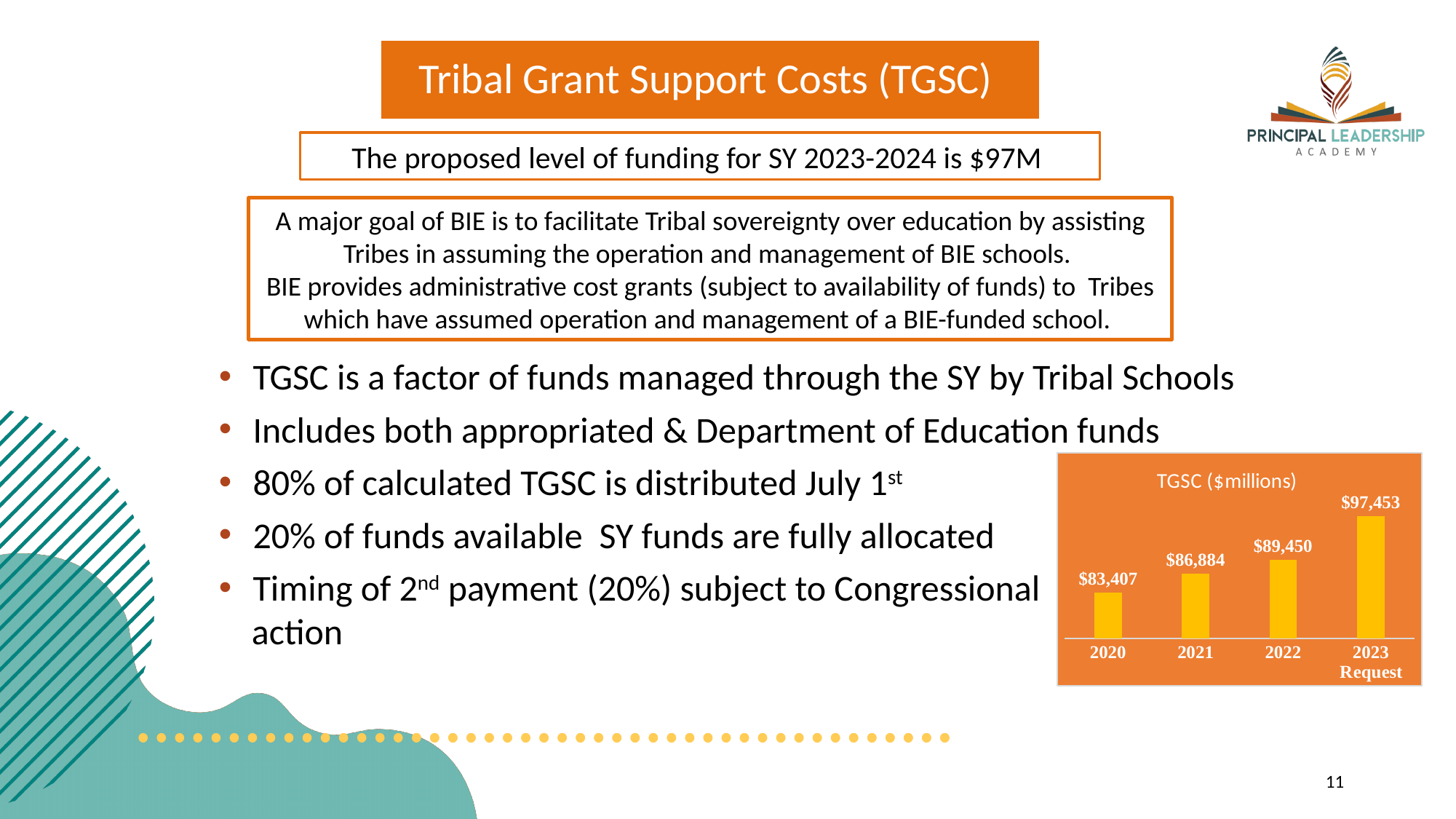
What is the TGSC value for 2020? $83,407 What is the TGSC value for 2022? $89,450 How many categories are shown in the TGSC chart? 4 What is the TGSC value for 2021? $86,884 Which is larger, the TGSC value for 2021 or for 2022? 2022 Which category has the highest TGSC value? 2023 Request What is the TGSC value for the 2023 Request? $97,453 What is the difference between the 2021 and 2020 TGSC values? $3,477 What kind of chart is the TGSC chart? bar chart Which category has the lowest TGSC value? 2020 What is the difference between the 2023 Request and the 2022 TGSC values? $8,003 Do the TGSC values rise or fall from 2020 to the 2023 Request? rise